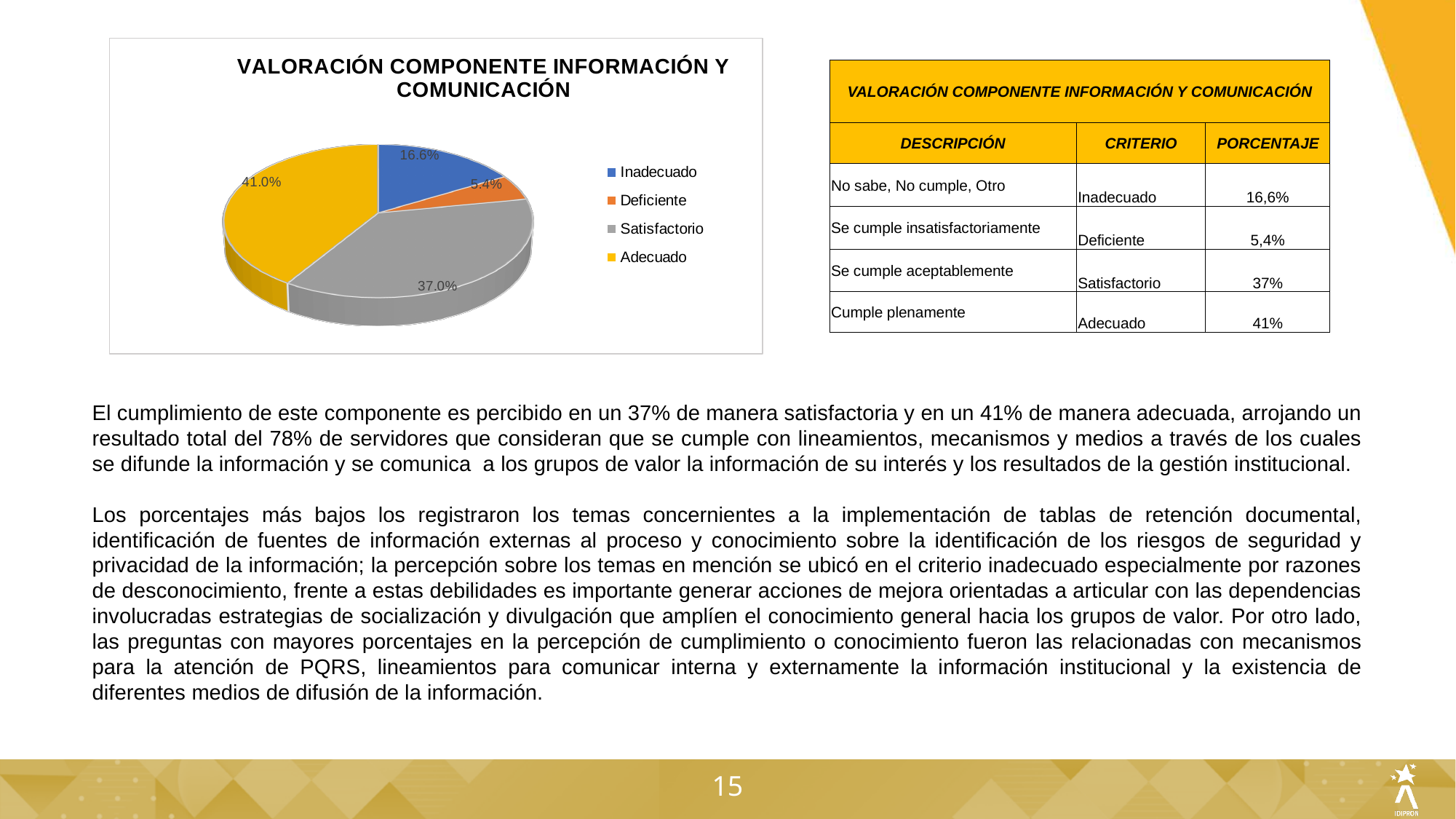
Which category has the smallest slice of the pie? Deficiente What type of chart is shown on the slide? Pie chart What percentage does the Deficiente slice show? 5.4% Which category has the largest slice of the pie? Adecuado What is the title of the chart? VALORACIÓN COMPONENTE INFORMACIÓN Y COMUNICACIÓN Which is larger, the Inadecuado slice or the Deficiente slice? Inadecuado How many categories does the legend list? 4 What is the difference in percentage points between the Adecuado and Satisfactorio slices? 4.0% What colour is the Adecuado slice in the pie chart? Yellow What percentage does the Satisfactorio slice show? 37.0% What percentage does the Inadecuado slice show? 16.6% What percentage does the Adecuado slice show? 41.0%